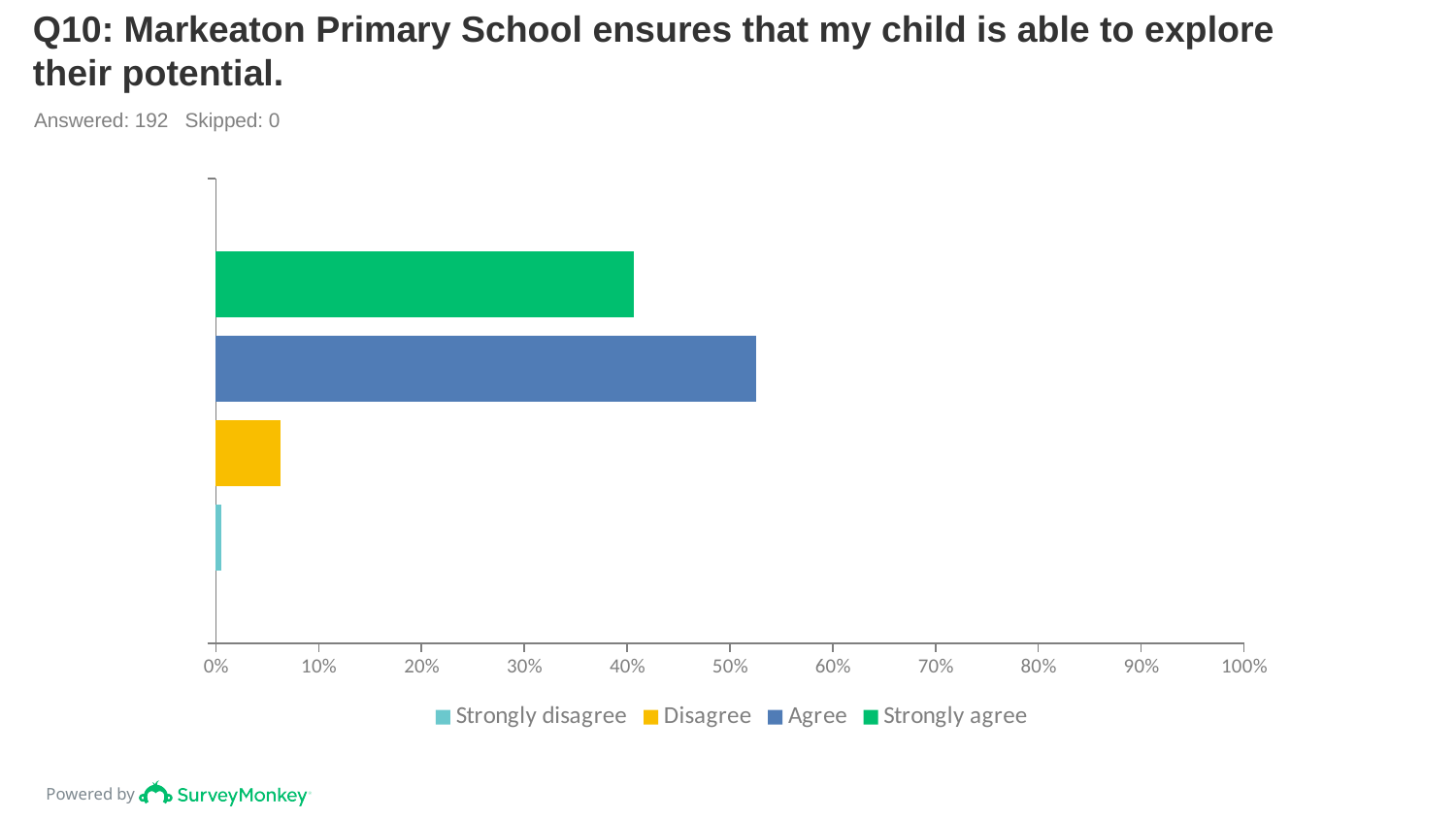
What colour is the bar for Strongly agree? green How many entries does the legend list? 4 Which response option has the highest value? Agree How many respondents answered this question, according to the slide? 192 Is the value for Disagree greater or less than 10%? less Which response option has the lowest value? Strongly disagree Which is larger, the value for Disagree or the value for Strongly disagree? Disagree Which is larger, the value for Agree or the value for Strongly agree? Agree Is the value for Agree greater or less than 50%? greater How many bars are plotted in the chart? 4 Is the value for Strongly agree greater or less than 50%? less What kind of chart is shown on the slide? bar chart